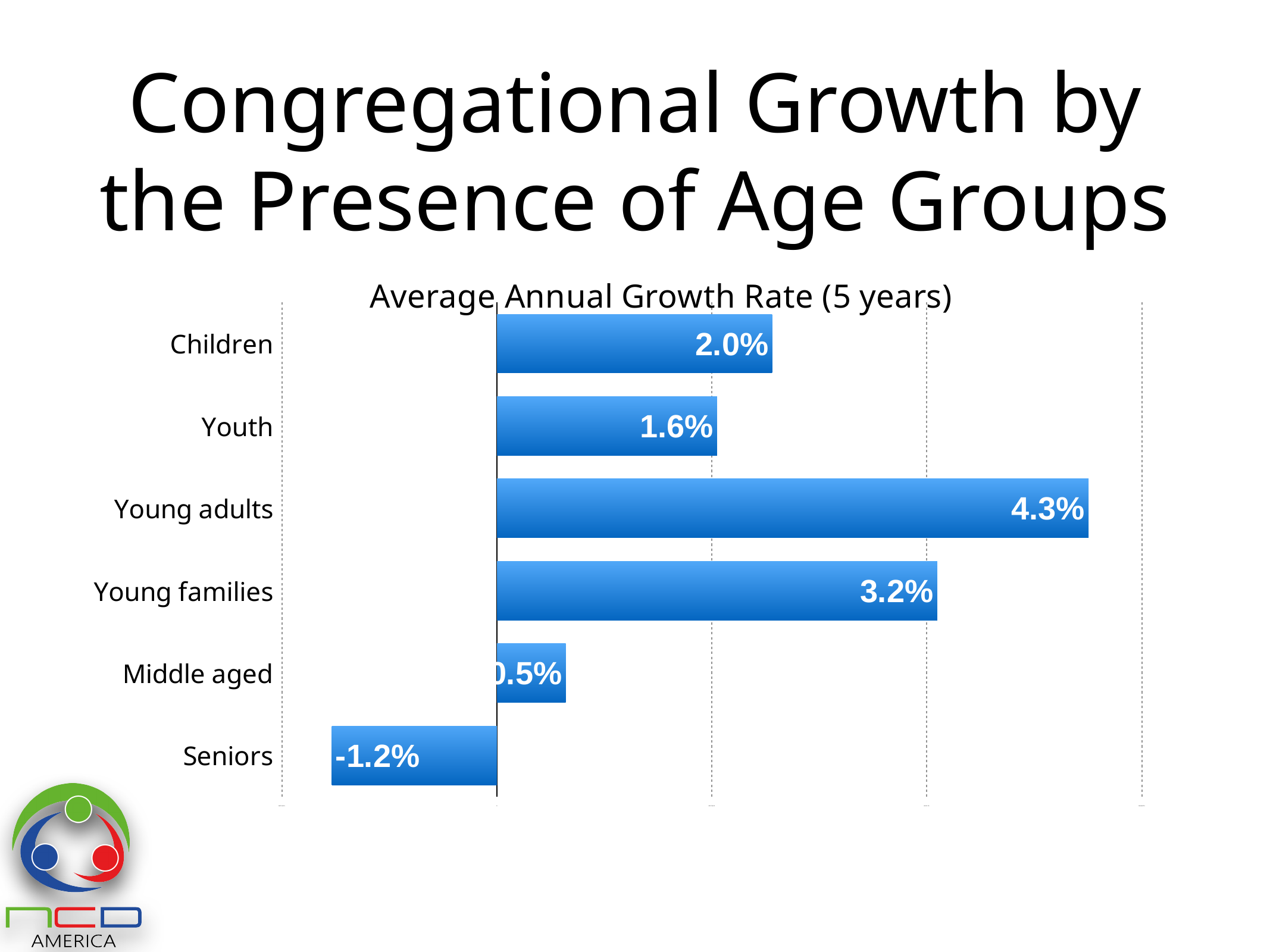
Which age group has the highest average annual growth rate? Young adults What is the title of the chart? Average Annual Growth Rate (5 years) What is the average annual growth rate for Young adults? 4.3% Which age group has the lowest average annual growth rate? Seniors What is the average annual growth rate for Young families? 3.2% What is the average annual growth rate for Children? 2.0% What is the difference between the growth rates for Young adults and Young families? 1.1% Which age group is the only one with a negative growth rate? Seniors What type of chart is shown on the slide? Bar chart Which has a higher growth rate, Children or Youth? Children What is the average annual growth rate for Seniors? -1.2% How many age groups are shown in the chart? 6